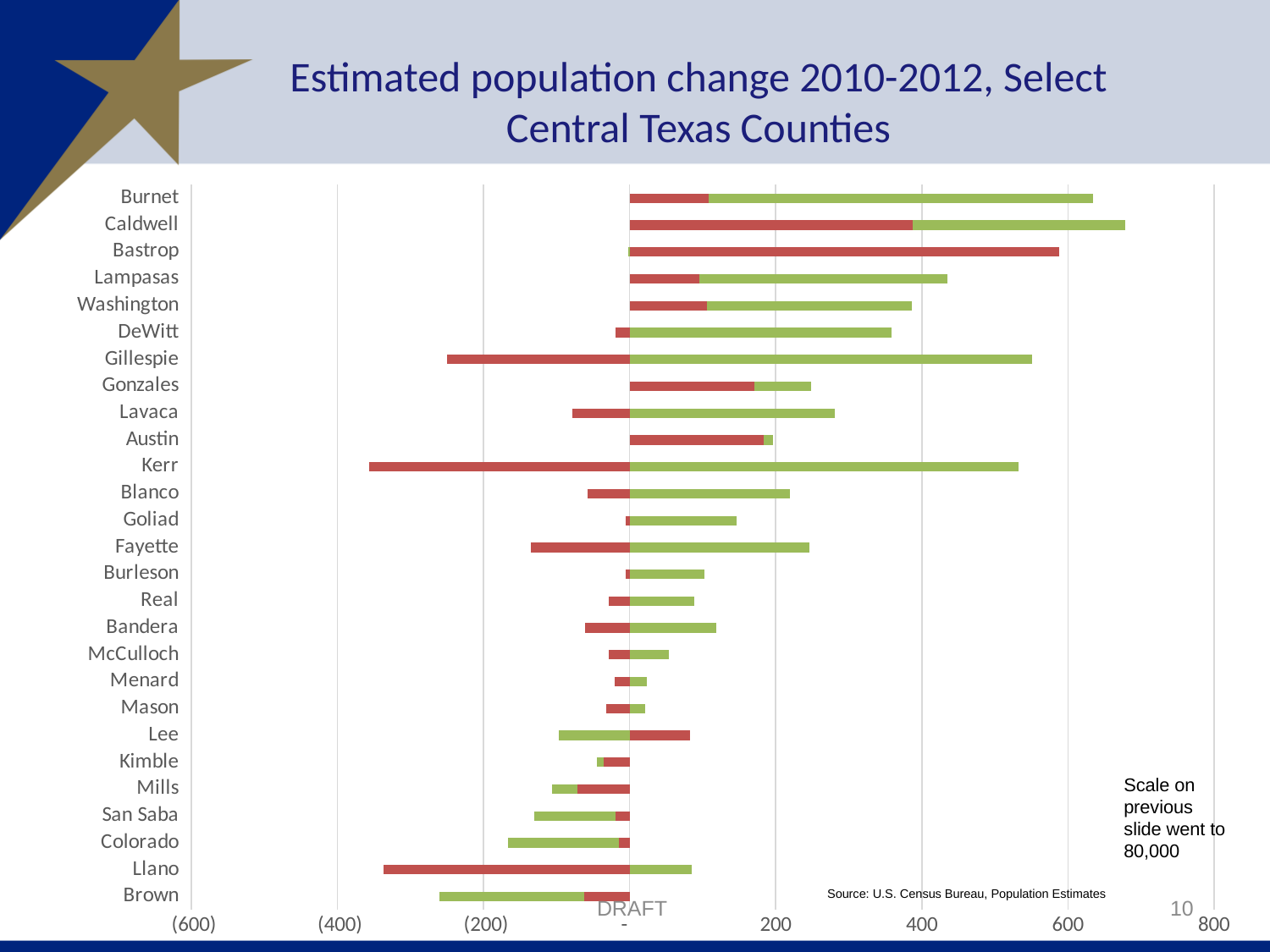
How many counties are listed on the vertical axis of the chart? 27 Is the right end of the Lampasas bar greater or less than 400? greater Is the right end of the Gillespie bar greater or less than 600? less Does the bar for Caldwell extend further to the right than the bar for Burnet? Yes Does the red segment for Kerr extend further to the left than the red segment for Gillespie? Yes What kind of chart is shown on the slide? Bar chart Is the right end of the Lavaca bar greater or less than 200? greater What is the title of the chart on the slide? Estimated population change 2010-2012, Select Central Texas Counties Which county's bar extends furthest to the right on the chart? Caldwell What source is cited for the chart data? U.S. Census Bureau, Population Estimates